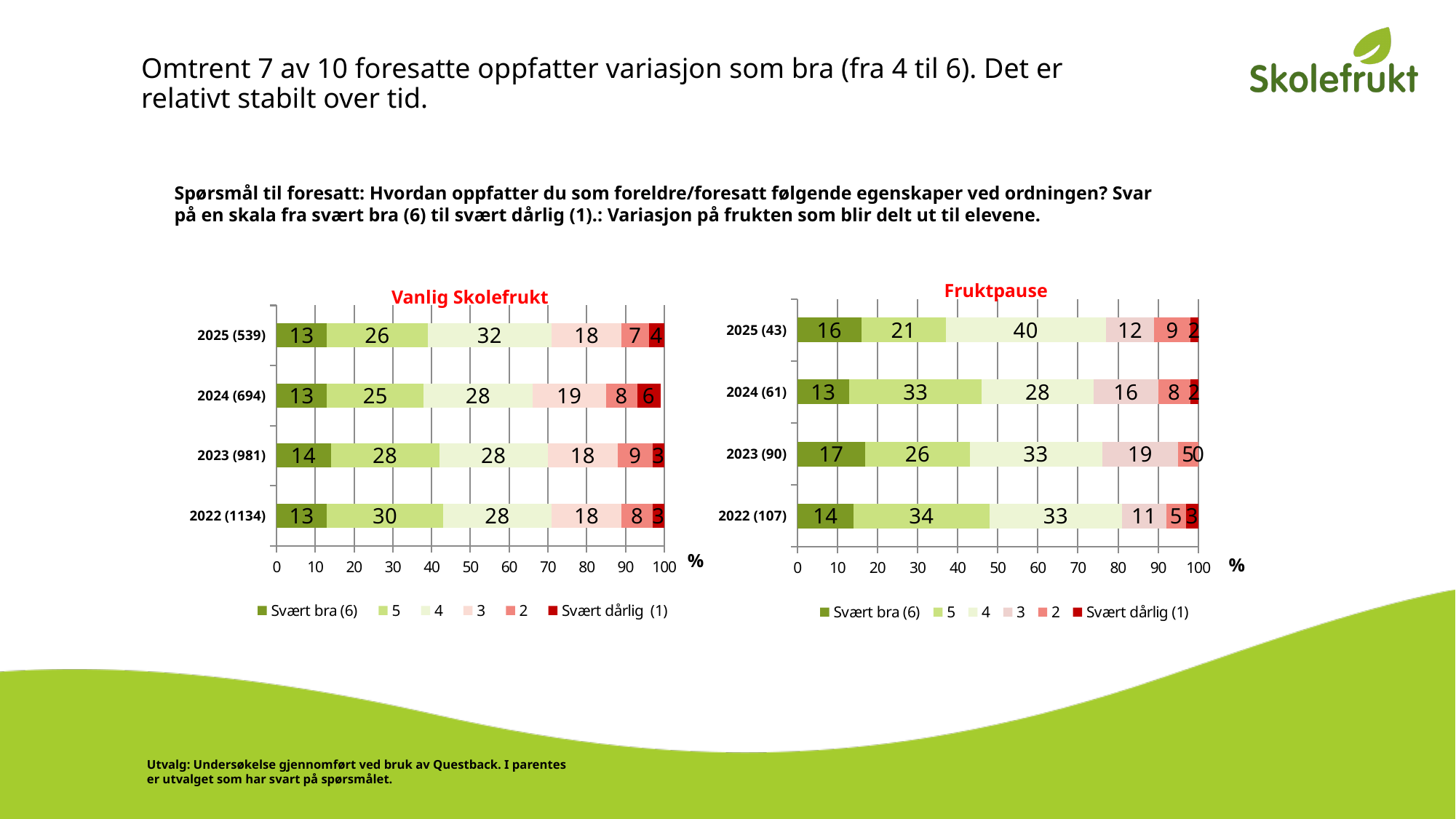
In the Fruktpause chart, what is the value for '5' in 2022 (107)? 34 In the Vanlig Skolefrukt chart, what is the value for 'Svært dårlig (1)' in 2024 (694)? 6 In the Fruktpause chart, what is the combined value of 'Svært bra (6)' and '5' in 2025 (43)? 37 How many series does the legend of the Fruktpause chart list? 6 In the Vanlig Skolefrukt chart, what is the value for '4' in 2025 (539)? 32 In the Fruktpause chart, what is the value for 'Svært bra (6)' in 2023 (90)? 17 In the Vanlig Skolefrukt chart, what is the difference between the '5' values for 2022 (1134) and 2025 (539)? 4 What kind of chart is the Vanlig Skolefrukt chart? Stacked bar chart In the Vanlig Skolefrukt chart, which year has the lowest value for '2'? 2025 (539) In the Fruktpause chart, which year has the highest value for '4'? 2025 (43) In the Fruktpause chart, is the value for '5' larger in 2024 (61) or in 2025 (43)? 2024 (61) How many years (bars) are shown in the Vanlig Skolefrukt chart? 4